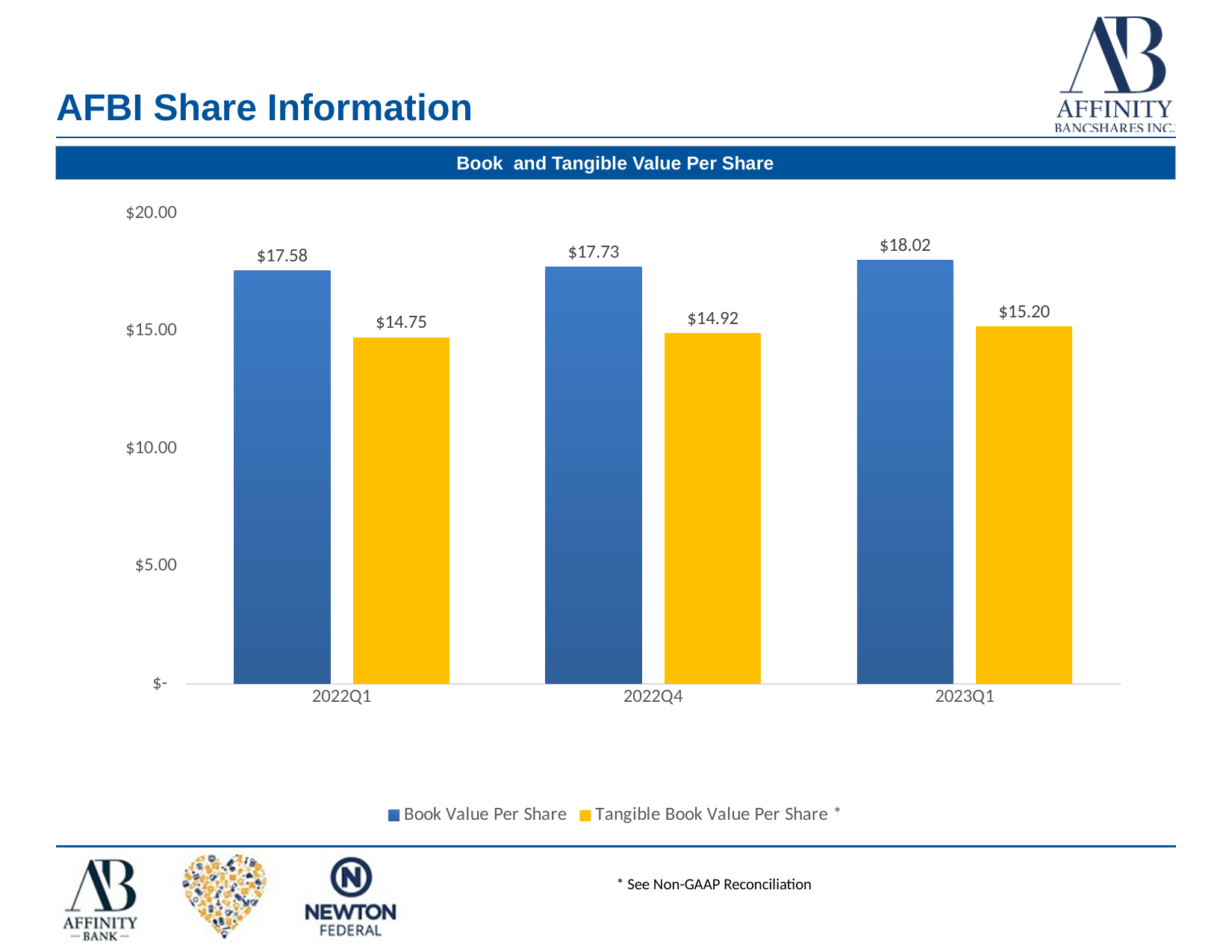
Which is larger: Book Value Per Share in 2022Q1 or Tangible Book Value Per Share in 2023Q1? Book Value Per Share in 2022Q1 What kind of chart is shown on the slide? Bar chart How many periods are shown on the x axis? 3 Is the Tangible Book Value Per Share for 2022Q4 greater or less than $15.00? less What is the difference between Book Value Per Share and Tangible Book Value Per Share in 2023Q1? $2.82 Which period has the highest Book Value Per Share? 2023Q1 How many series does the legend list? 2 Which period has the lowest Tangible Book Value Per Share? 2022Q1 What is the Tangible Book Value Per Share for 2023Q1? $15.20 What is the Tangible Book Value Per Share for 2022Q1? $14.75 What is the Book Value Per Share for 2022Q4? $17.73 By how much did Book Value Per Share increase from 2022Q1 to 2023Q1? $0.44